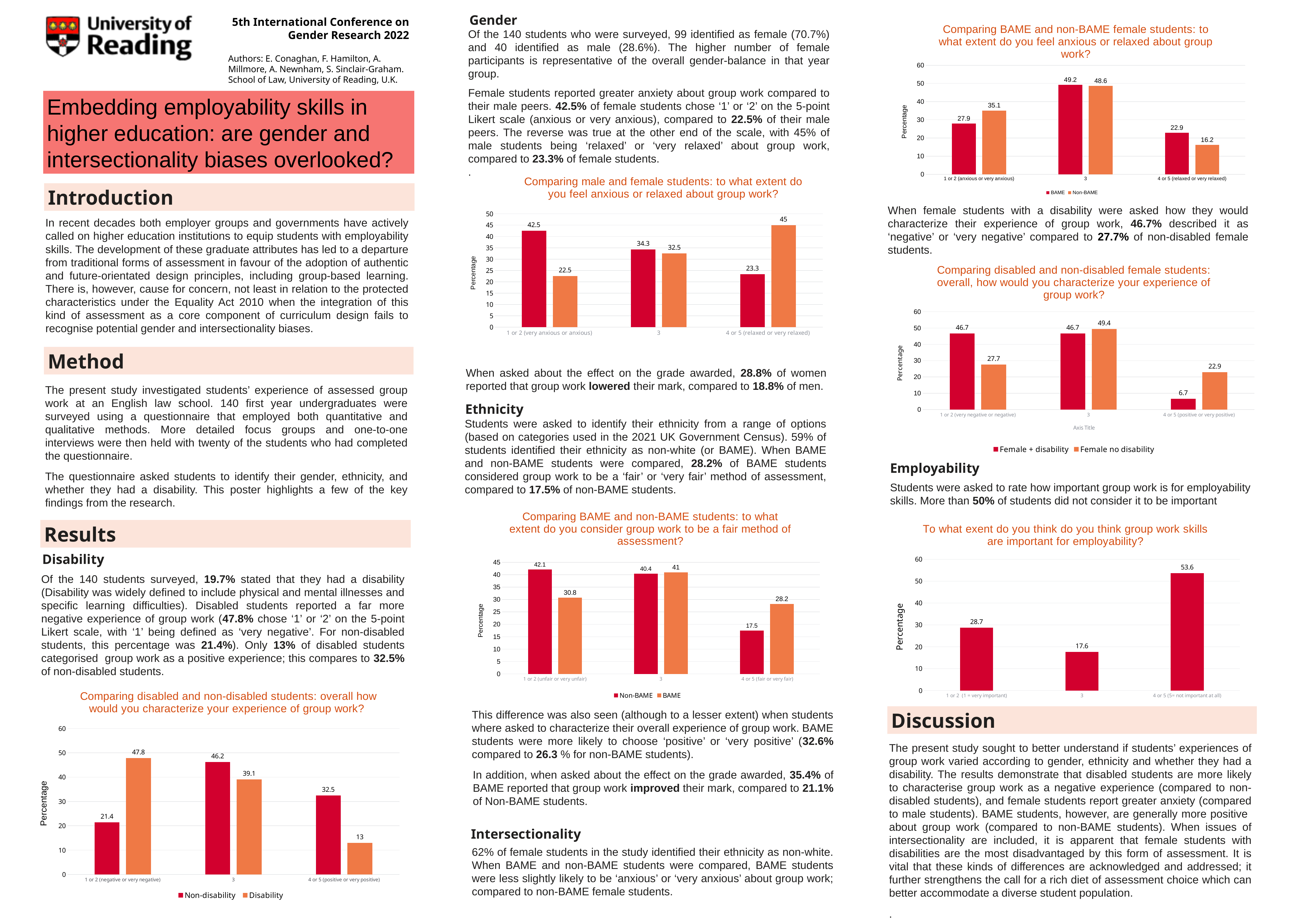
In the chart 'Comparing BAME and non-BAME female students: to what extent do you feel anxious or relaxed about group work?', what is the value for Non-BAME in the '1 or 2 (anxious or very anxious)' category? 35.1 In the chart 'Comparing BAME and non-BAME female students: to what extent do you feel anxious or relaxed about group work?', which category has the lowest Non-BAME value? 4 or 5 (relaxed or very relaxed) In the chart 'Comparing disabled and non-disabled students: overall how would you characterize your experience of group work?', what is the difference between the Non-disability and Disability values in the '4 or 5 (positive or very positive)' category? 19.5 In the chart 'To what exent do you think do you think group work skills are important for employability?', how many categories are shown on the x axis? 3 In the chart 'Comparing BAME and non-BAME students: to what extent do you consider group work to be a fair method of assessment?', which is larger in the '1 or 2 (unfair or very unfair)' category, Non-BAME or BAME? Non-BAME In the chart 'Comparing disabled and non-disabled students: overall how would you characterize your experience of group work?', how many series does the legend list? 2 In the chart 'Comparing male and female students: to what extent do you feel anxious or relaxed about group work?', what is the value of the orange bar in the '4 or 5 (relaxed or very relaxed)' category? 45 In the chart 'Comparing male and female students: to what extent do you feel anxious or relaxed about group work?', which category has the highest red bar? 1 or 2 (very anxious or anxious) In the chart 'Comparing disabled and non-disabled female students: overall, how would you characterize your experience of group work?', what is the value for 'Female + disability' in the '4 or 5 (positive or very positive)' category? 6.7 What type of chart is 'To what exent do you think do you think group work skills are important for employability?'? Bar chart In the chart 'Comparing BAME and non-BAME students: to what extent do you consider group work to be a fair method of assessment?', what is the value for BAME in the '4 or 5 (fair or very fair)' category? 28.2 In the chart 'Comparing disabled and non-disabled students: overall how would you characterize your experience of group work?', what is the value for Disability in the '1 or 2 (negative or very negative)' category? 47.8